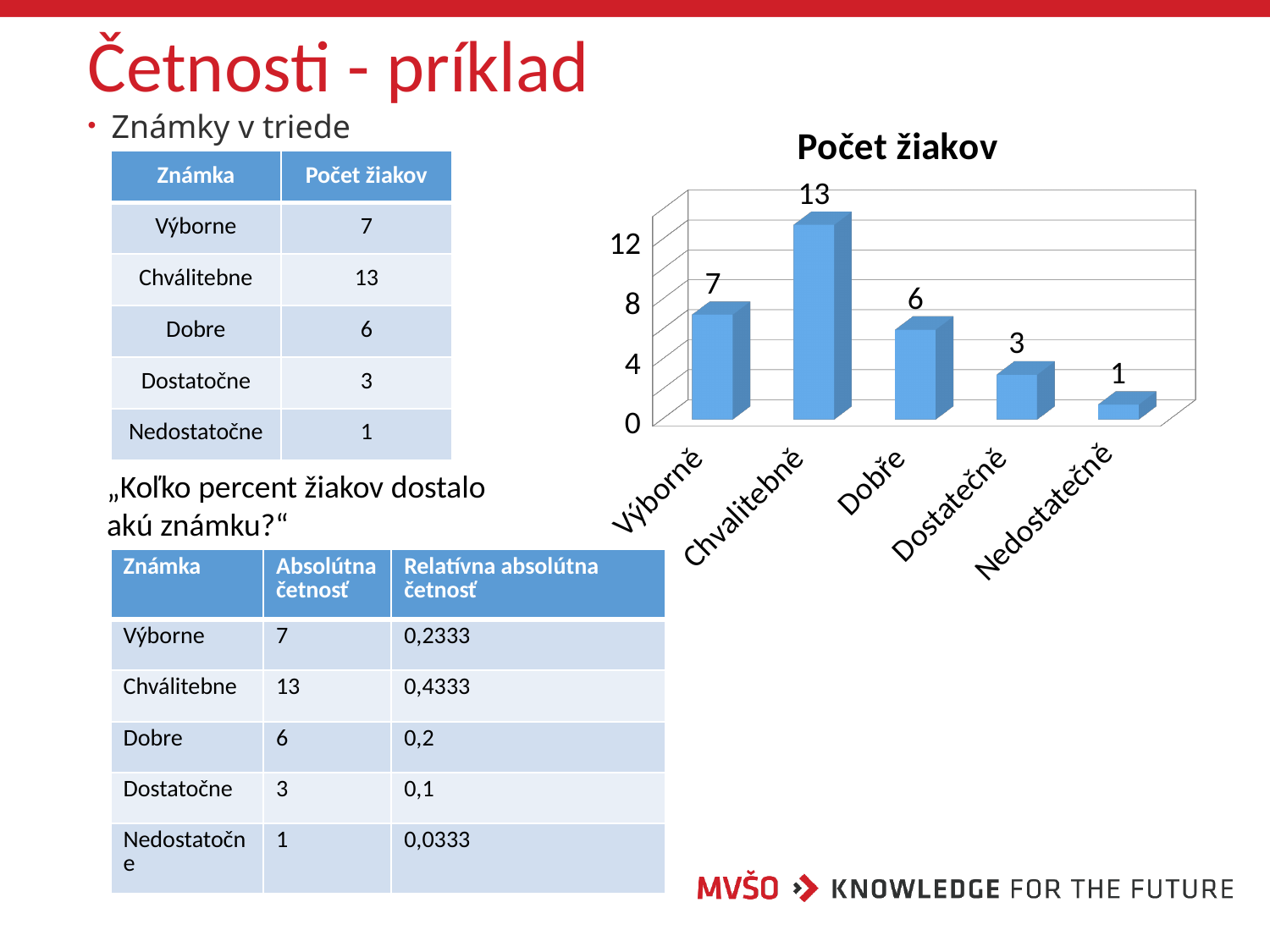
What is the value for Chvalitebně in the Počet žiakov chart? 13 Which category has the lowest value in the Počet žiakov chart? Nedostatečně What is the difference between the values for Chvalitebně and Výborně in the Počet žiakov chart? 6 What is the title of the chart on the slide? Počet žiakov Do the values in the Počet žiakov chart rise or fall from Chvalitebně to Nedostatečně? fall Is the value for Chvalitebně in the Počet žiakov chart greater or less than 12? greater What is the value for Dostatečně in the Počet žiakov chart? 3 Which category has the highest value in the Počet žiakov chart? Chvalitebně What kind of chart is the Počet žiakov chart? bar chart What is the value for Nedostatečně in the Počet žiakov chart? 1 Which is larger in the Počet žiakov chart, the value for Výborně or the value for Dobře? Výborně How many categories are shown in the Počet žiakov chart? 5